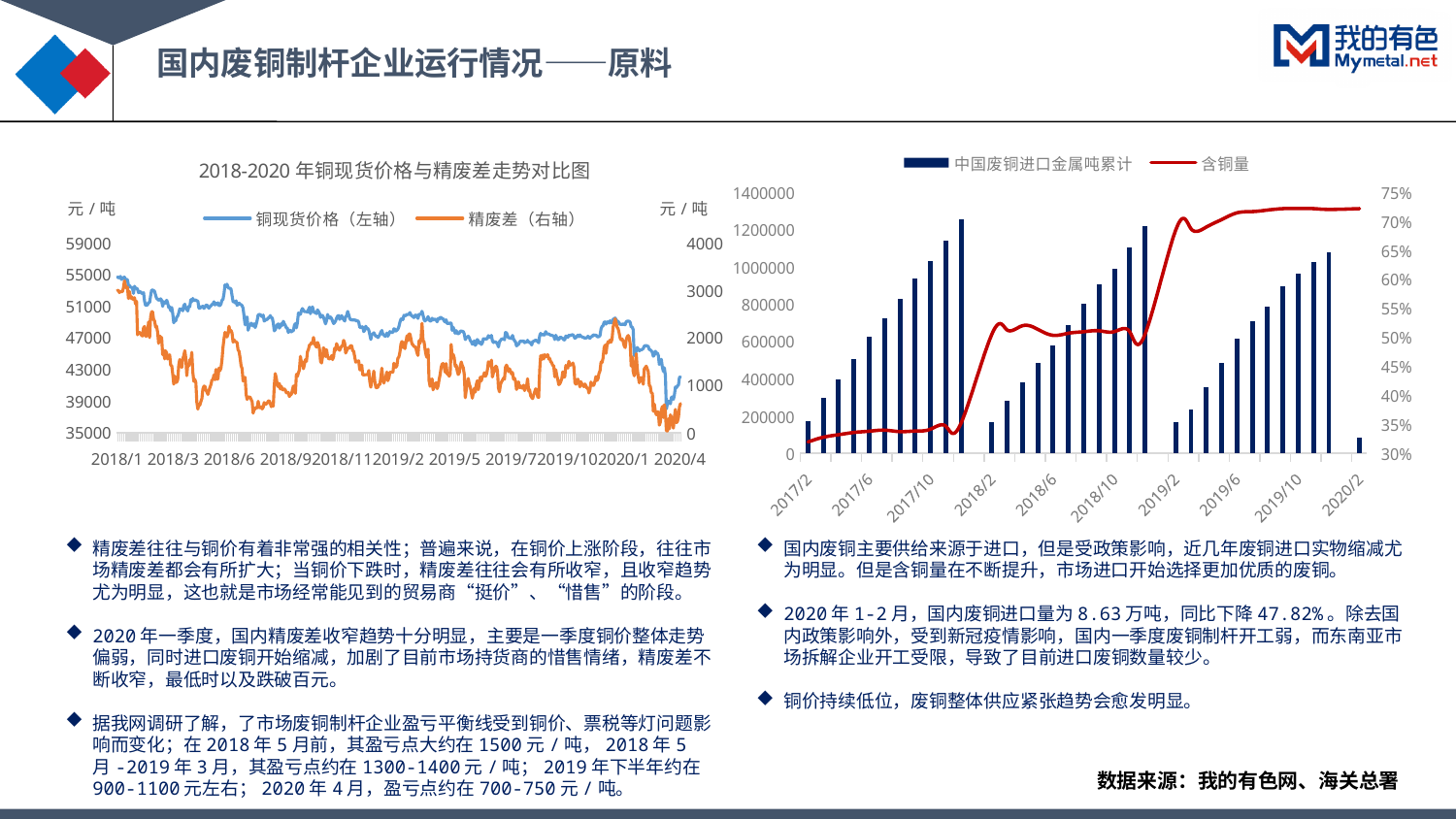
In the left chart (2018-2020年铜现货价格与精废差走势对比图), does 铜现货价格 overall rise or fall from 2018/1 to 2020/4? fall How many series does the legend of the left chart (2018-2020年铜现货价格与精废差走势对比图) list? 2 In the left chart (2018-2020年铜现货价格与精废差走势对比图), is the value of 精废差 at 2020/4 greater or less than 2000? less In the left chart (2018-2020年铜现货价格与精废差走势对比图), which series is plotted on the right axis according to the legend? 精废差（右轴） In the right chart (中国废铜进口金属吨累计 / 含铜量), is the value of 含铜量 at 2017/2 greater or less than 35%? less In the left chart (2018-2020年铜现货价格与精废差走势对比图), is the value of 铜现货价格 at 2018/1 greater or less than 51000? greater What kind of chart is the right chart showing 中国废铜进口金属吨累计 and 含铜量? bar and line chart In the right chart (中国废铜进口金属吨累计 / 含铜量), does 含铜量 overall rise or fall from 2017/2 to 2020/2? rise How many series does the legend of the right chart (中国废铜进口金属吨累计 / 含铜量) list? 2 What is the highest tick shown on the left vertical axis of the left chart (2018-2020年铜现货价格与精废差走势对比图)? 59000 What kind of chart is the left chart titled 2018-2020年铜现货价格与精废差走势对比图? line chart